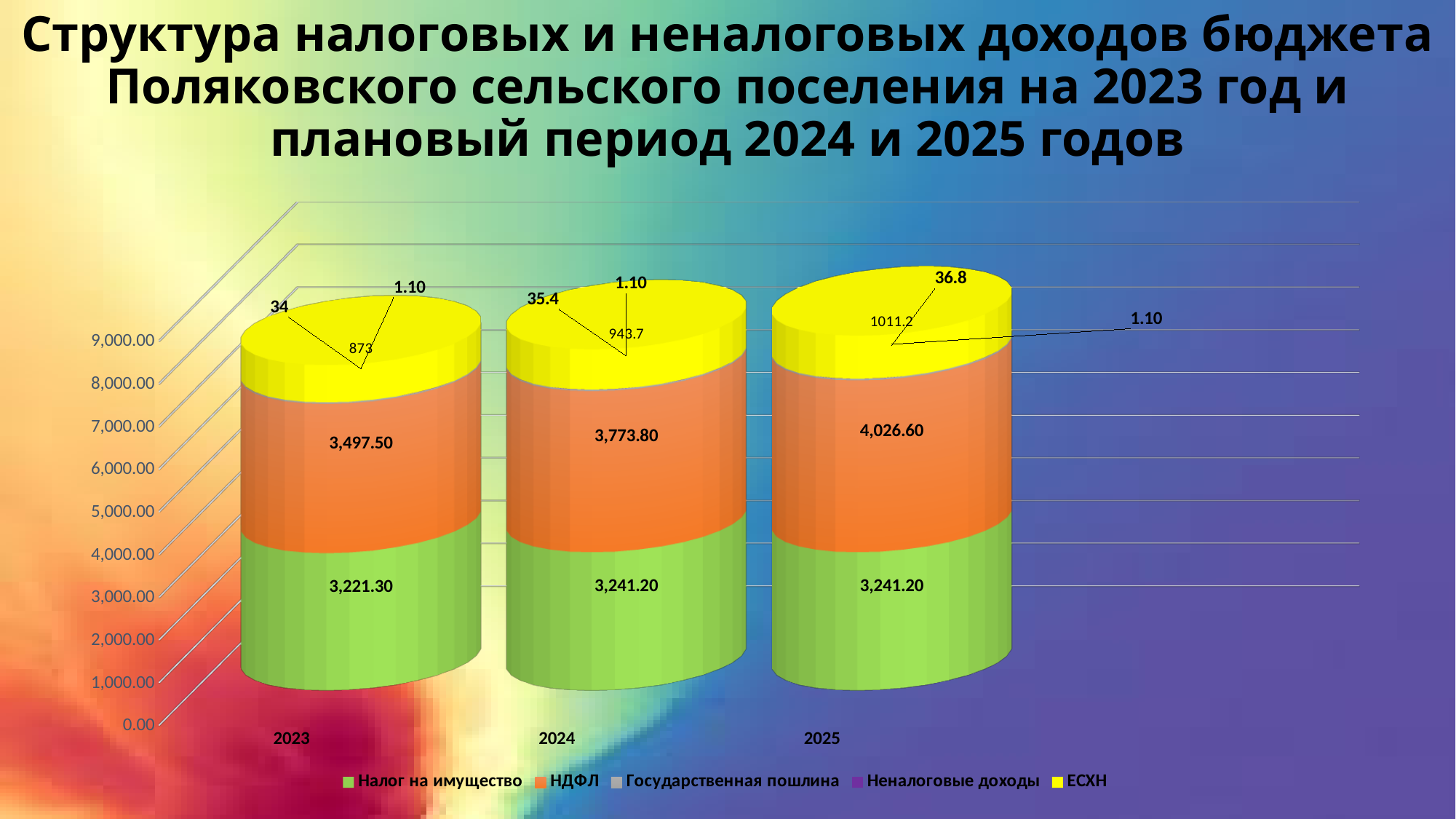
What colour represents ЕСХН in the chart legend? Yellow What is the value of НДФЛ for 2025? 4,026.60 How many series does the chart legend list? 5 What is the value of Налог на имущество for 2025? 3,241.20 What is the difference between the НДФЛ values for 2024 and 2023? 276.30 In which year is the НДФЛ value the highest? 2025 For 2023, which is larger: НДФЛ or Налог на имущество? НДФЛ What kind of chart is shown on the slide? Stacked bar chart Does the НДФЛ value rise or fall from 2023 to 2025? Rises What is the value of Налог на имущество for 2023? 3,221.30 How many years (categories) are shown on the x axis of the chart? 3 What is the value of НДФЛ for 2024? 3,773.80